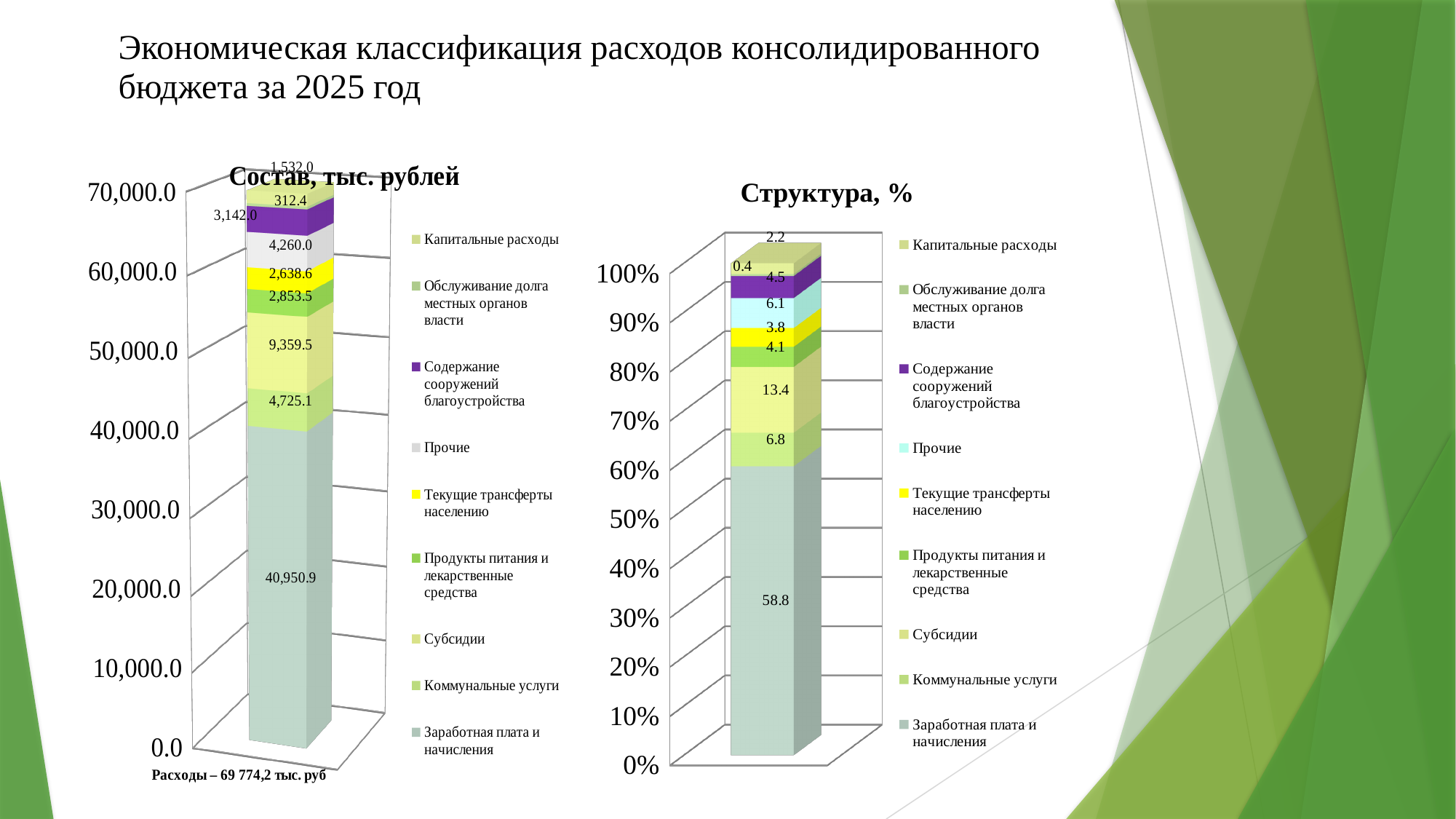
In the chart titled "Состав, тыс. рублей", what is the difference between the values for Субсидии and Коммунальные услуги? 4,634.4 How many series does the legend of the chart titled "Структура, %" list? 9 What is the title of the chart on the right side of the slide? Структура, % In the chart titled "Структура, %", what is the value for Субсидии? 13.4 In the chart titled "Структура, %", what is the value for Прочие? 6.1 In the chart titled "Структура, %", what share does Заработная плата и начисления have? 58.8 In the chart titled "Состав, тыс. рублей", which category has the largest value? Заработная плата и начисления In the chart titled "Состав, тыс. рублей", which is larger: Прочие or Содержание сооружений благоустройства? Прочие In the chart titled "Состав, тыс. рублей", what is the value for Субсидии? 9,359.5 What kind of chart is the chart titled "Состав, тыс. рублей"? Stacked bar chart In the chart titled "Состав, тыс. рублей", which category has the smallest value? Обслуживание долга местных органов власти In the chart titled "Состав, тыс. рублей", what is the value for Заработная плата и начисления? 40,950.9